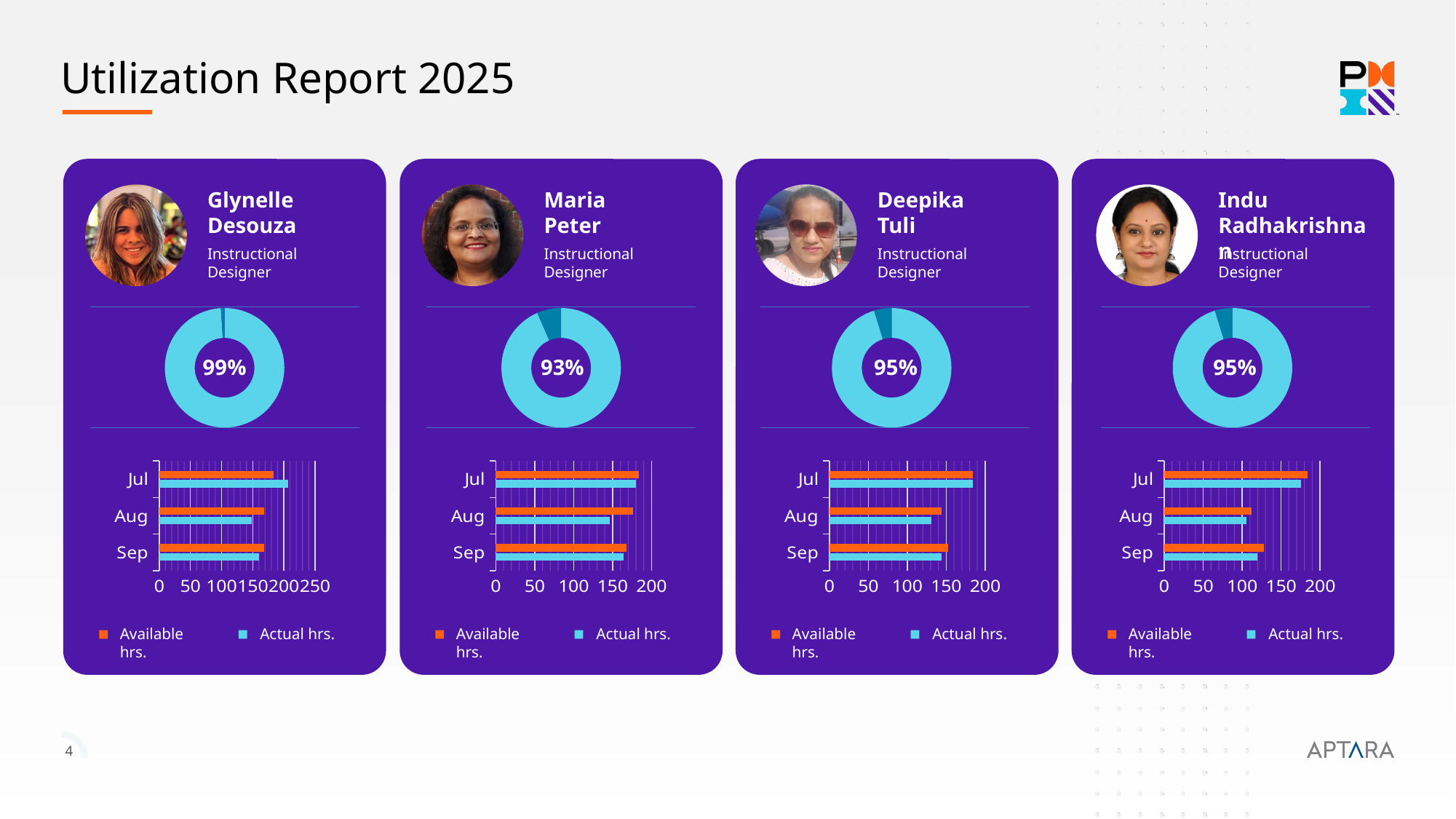
In the bar chart on Deepika Tuli's card, is the Available hrs. value for Jul greater or less than 150? greater What is the difference between Glynelle Desouza's and Maria Peter's utilization percentages shown in their donut charts? 6% How many months are shown on the bar chart on Deepika Tuli's card? 3 Across the four donut charts on the slide, which person has the lowest utilization percentage? Maria Peter What kind of chart is used below each donut chart to show Available hrs. and Actual hrs.? Bar chart On Maria Peter's card, what utilization percentage is shown in the donut chart? 93% How many series does the legend list in the bar chart on Indu Radhakrishnan's card? 2 In the bar chart on Indu Radhakrishnan's card, which month has the highest Available hrs.? Jul On Glynelle Desouza's card, what utilization percentage is shown in the centre of the donut chart? 99% Across the four donut charts on the slide, which person has the highest utilization percentage? Glynelle Desouza In the bar chart on Indu Radhakrishnan's card, is the Available hrs. value for Aug greater or less than 150? less Which is larger: Deepika Tuli's utilization percentage or Maria Peter's? Deepika Tuli's